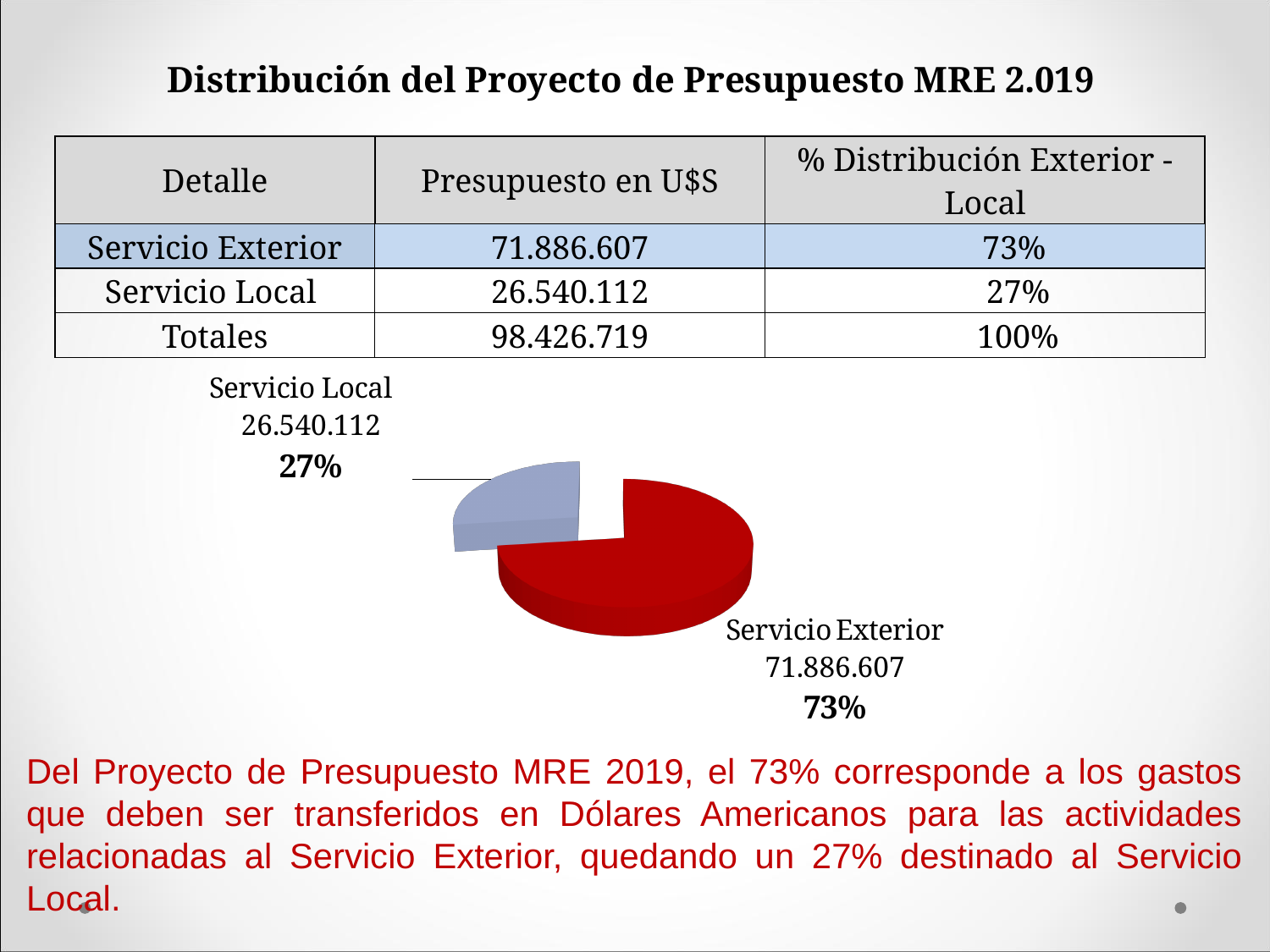
What colour is the Servicio Exterior slice in the pie chart? Red Which slice of the pie chart is the smallest? Servicio Local How many slices does the pie chart have? 2 Which is larger in the pie chart, Servicio Exterior or Servicio Local? Servicio Exterior What is the value shown for Servicio Exterior in the pie chart? 71.886.607 What share of the pie does Servicio Exterior represent? 73% What share of the pie does Servicio Local represent? 27% What colour is the Servicio Local slice in the pie chart? Light blue What kind of chart is shown on the slide? Pie chart Which slice of the pie chart is the largest? Servicio Exterior What is the difference in percentage points between the Servicio Exterior and Servicio Local shares? 46% What is the value shown for Servicio Local in the pie chart? 26.540.112